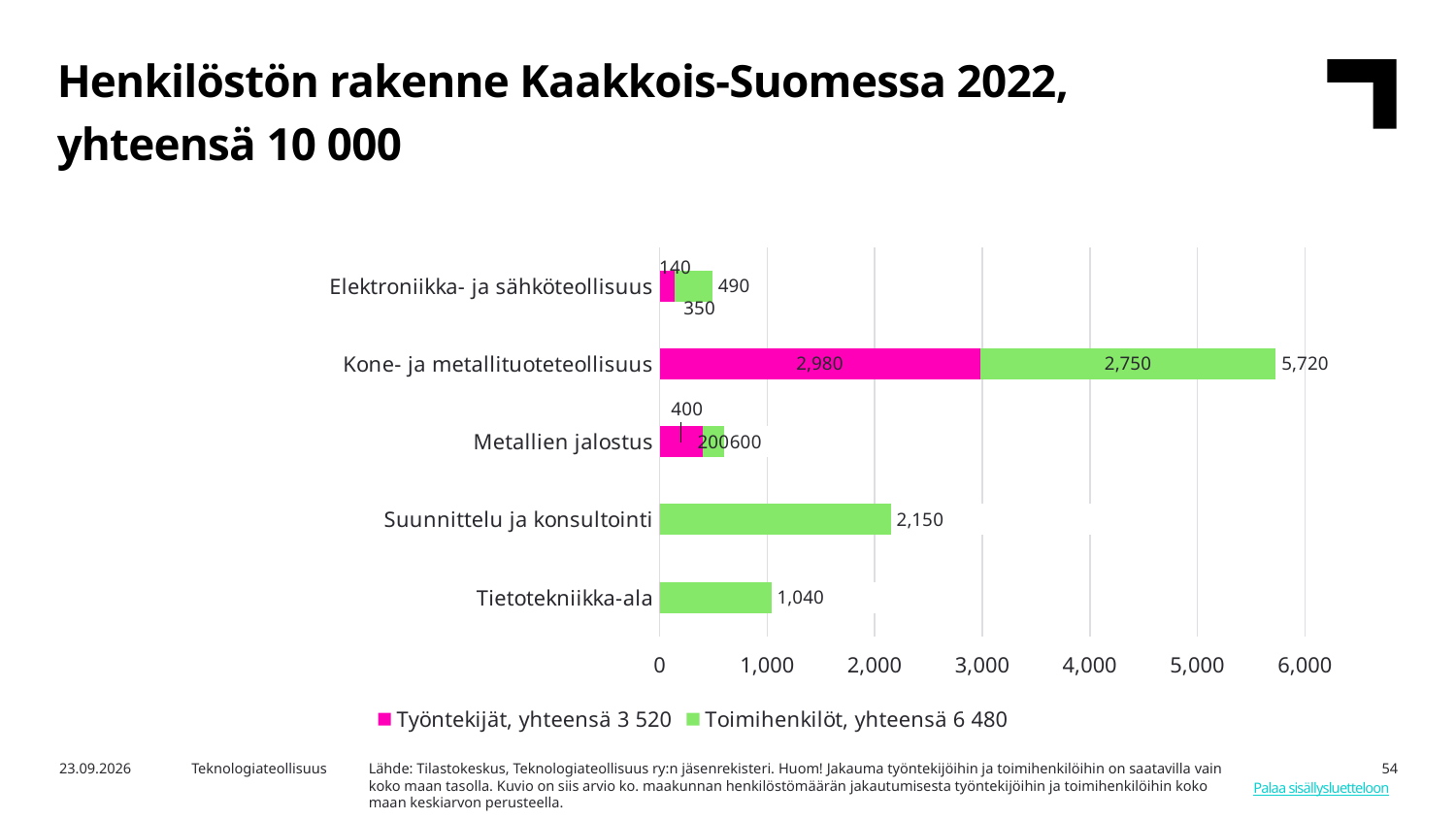
What is the value for Tietotekniikka-ala? 1,040 What is the difference between the Työntekijät and Toimihenkilöt values for Kone- ja metallituoteteollisuus? 230 What is the Toimihenkilöt value for Kone- ja metallituoteteollisuus? 2,750 How many series does the legend list? 2 Which is larger: the value for Suunnittelu ja konsultointi or the value for Tietotekniikka-ala? Suunnittelu ja konsultointi What is the total for the Kone- ja metallituoteteollisuus bar? 5,720 Which category has the longest total bar? Kone- ja metallituoteteollisuus Which category has the shortest total bar? Elektroniikka- ja sähköteollisuus How many categories are shown on the chart? 5 What type of chart is shown on the slide? stacked bar chart What is the Työntekijät value for Kone- ja metallituoteteollisuus? 2,980 What is the Toimihenkilöt value for Suunnittelu ja konsultointi? 2,150